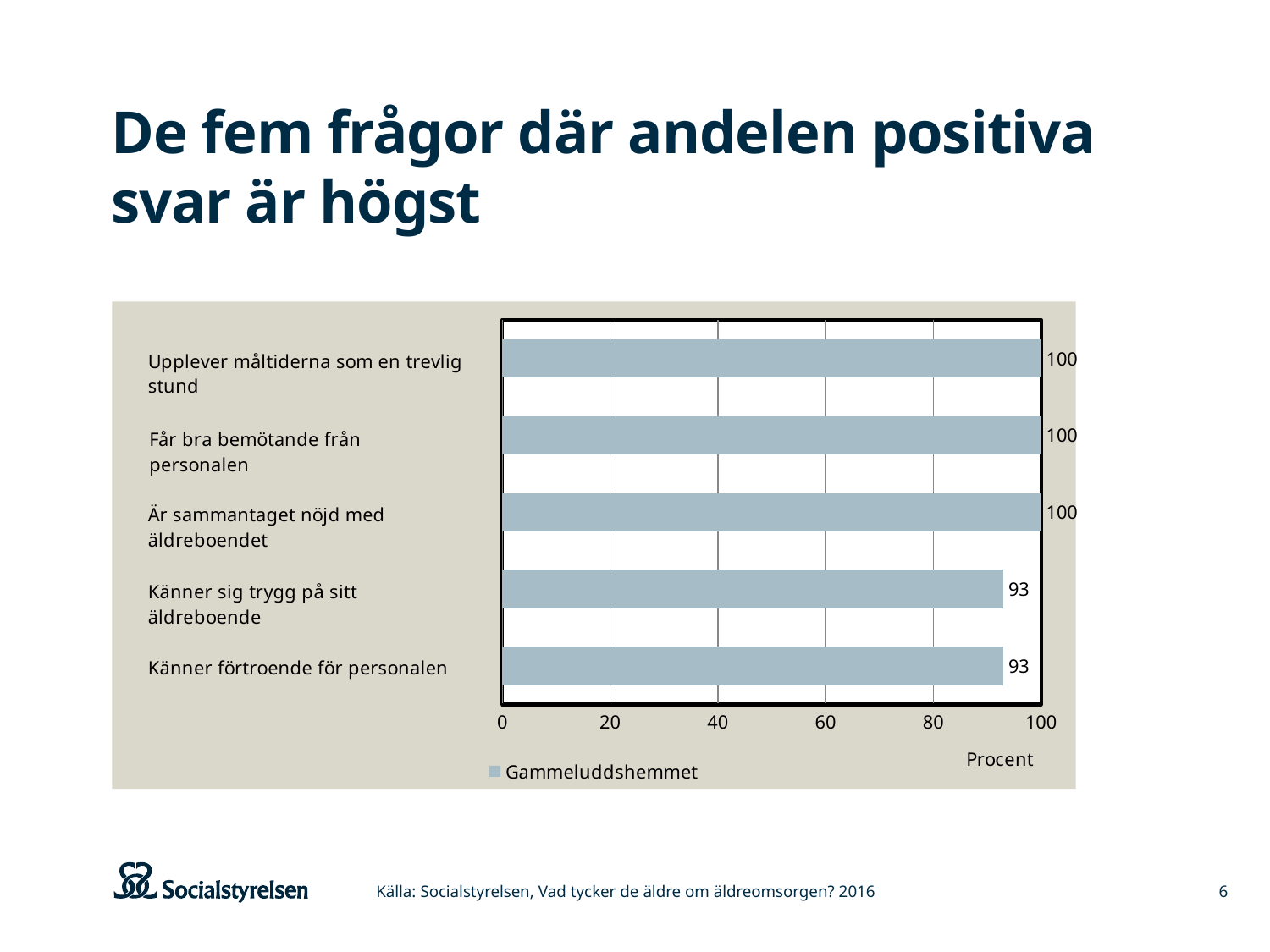
What is the label of the horizontal axis? Procent Which is larger, the value for "Får bra bemötande från personalen" or the value for "Känner sig trygg på sitt äldreboende"? Får bra bemötande från personalen What kind of chart is shown on the slide? bar chart Is the value for "Känner förtroende för personalen" greater or less than 80? greater What is the value for "Får bra bemötande från personalen"? 100 What is the value for "Känner sig trygg på sitt äldreboende"? 93 What series name is shown in the chart legend? Gammeluddshemmet How many categories are shown in the chart? 5 What is the difference between the value for "Upplever måltiderna som en trevlig stund" and the value for "Känner förtroende för personalen"? 7 What is the value for "Är sammantaget nöjd med äldreboendet"? 100 How many series does the legend list? 1 What is the value for "Känner förtroende för personalen"? 93